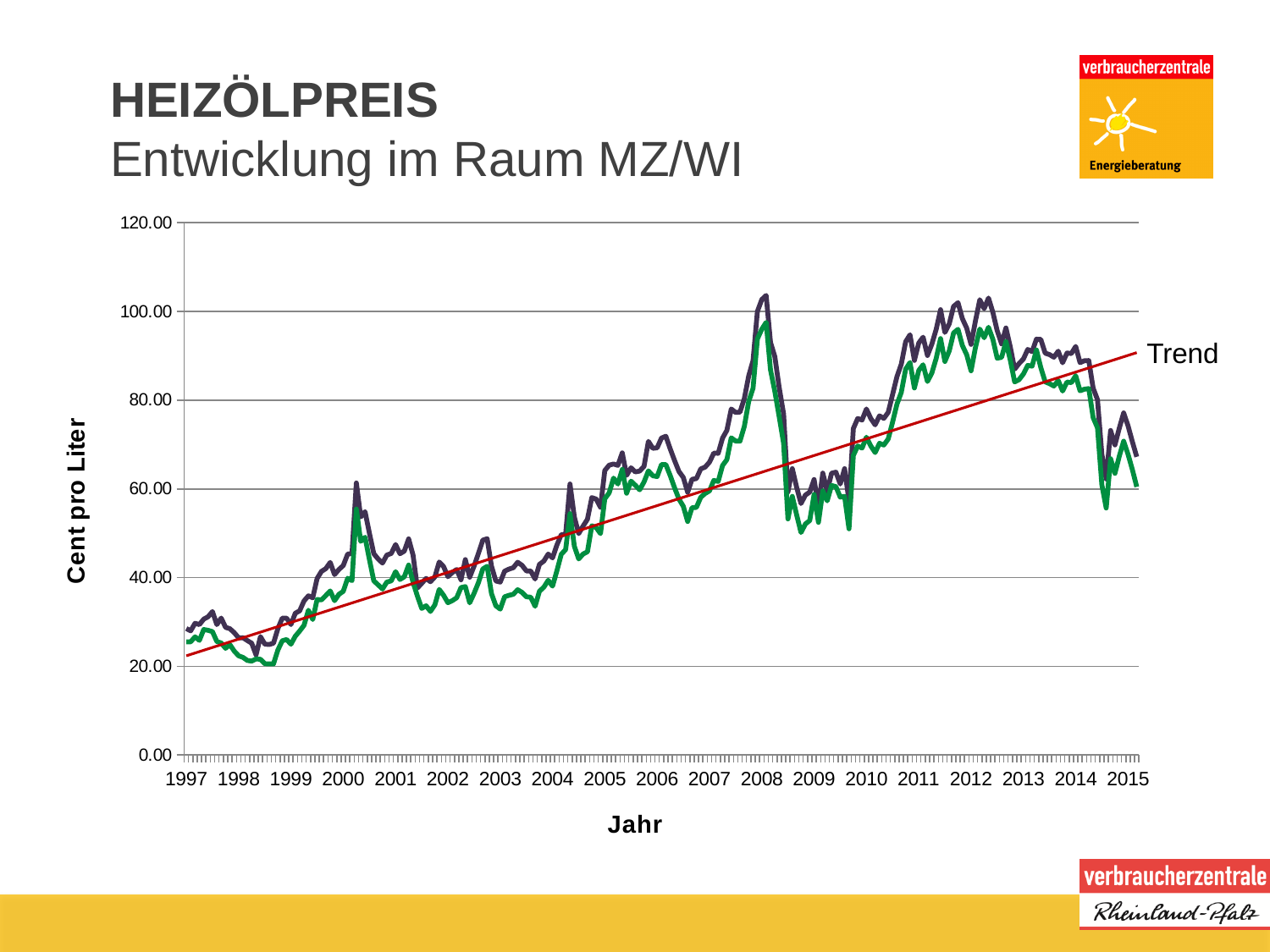
What kind of chart is shown on the slide? line chart Is the price around 2003 greater or less than 60? less Does the red trend line rise or fall from 1997 to 2015? rise Is the price around 2012 greater or less than 80? greater Is the lowest price around 1998/1999 greater or less than 40? less Which is higher, the peak price around 2008 or the price in 1997? the peak around 2008 What is the title of the y axis? Cent pro Liter Between 2012 and 2015, do the plotted price lines rise or fall overall? fall How many year labels are shown on the x axis? 19